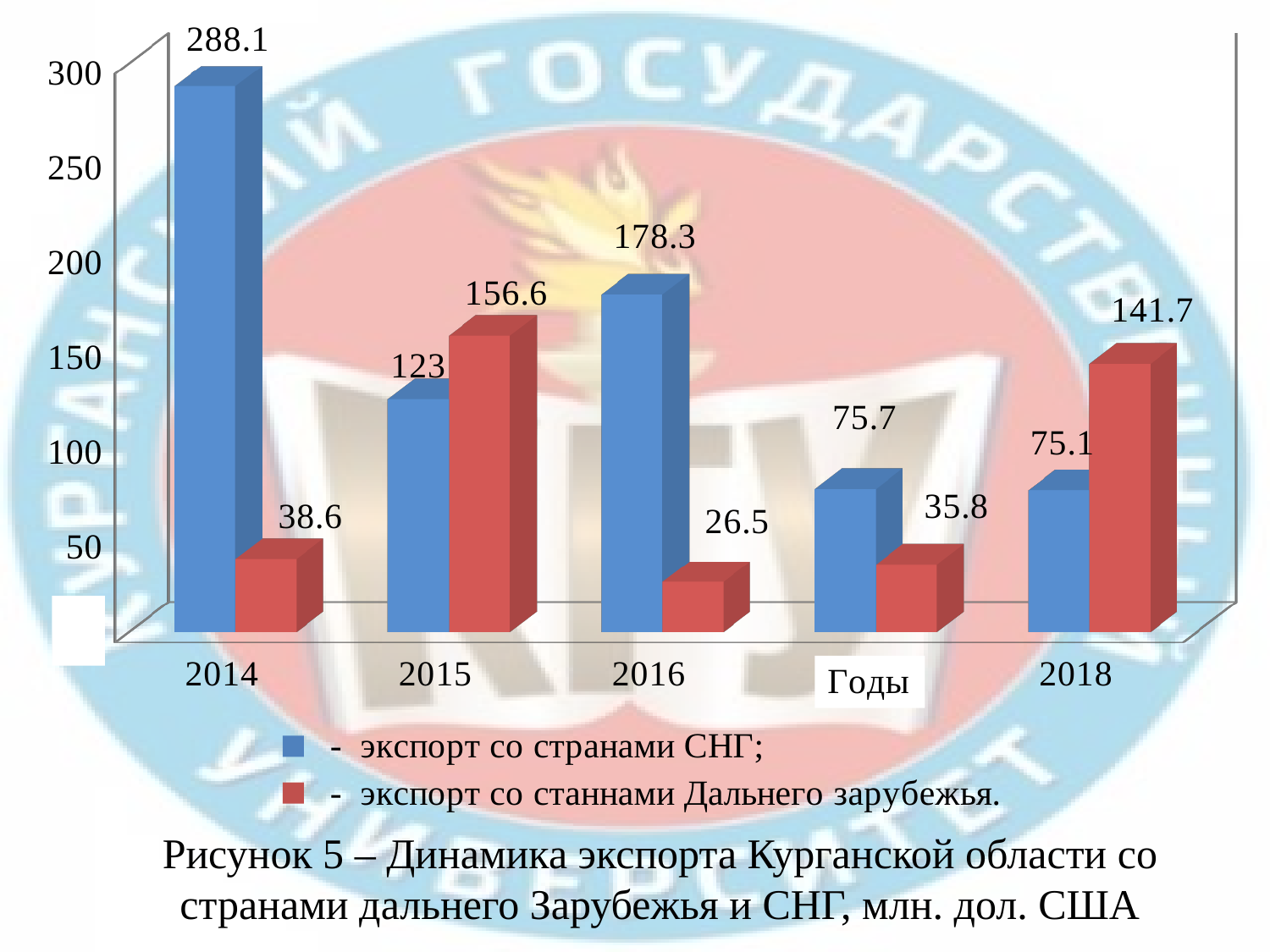
In 2018, which is larger: export to CIS countries or export to far-abroad countries? Export to far-abroad countries What kind of chart is shown on the slide? Bar chart What is the value of export to far-abroad countries in 2018? 141.7 By how much did export to CIS countries fall from 2014 to 2016? 109.8 In which year is export to far-abroad countries the lowest? 2016 What is the value of export to CIS countries (экспорт со странами СНГ) in 2014? 288.1 In which year is export to CIS countries the highest? 2014 How many series does the legend list? 2 What is the value of export to far-abroad countries (Дальнего зарубежья) in 2015? 156.6 What is the value of export to CIS countries in 2016? 178.3 How many years (categories) are shown on the chart? 5 In 2015, how much larger is export to far-abroad countries than export to CIS countries? 33.6